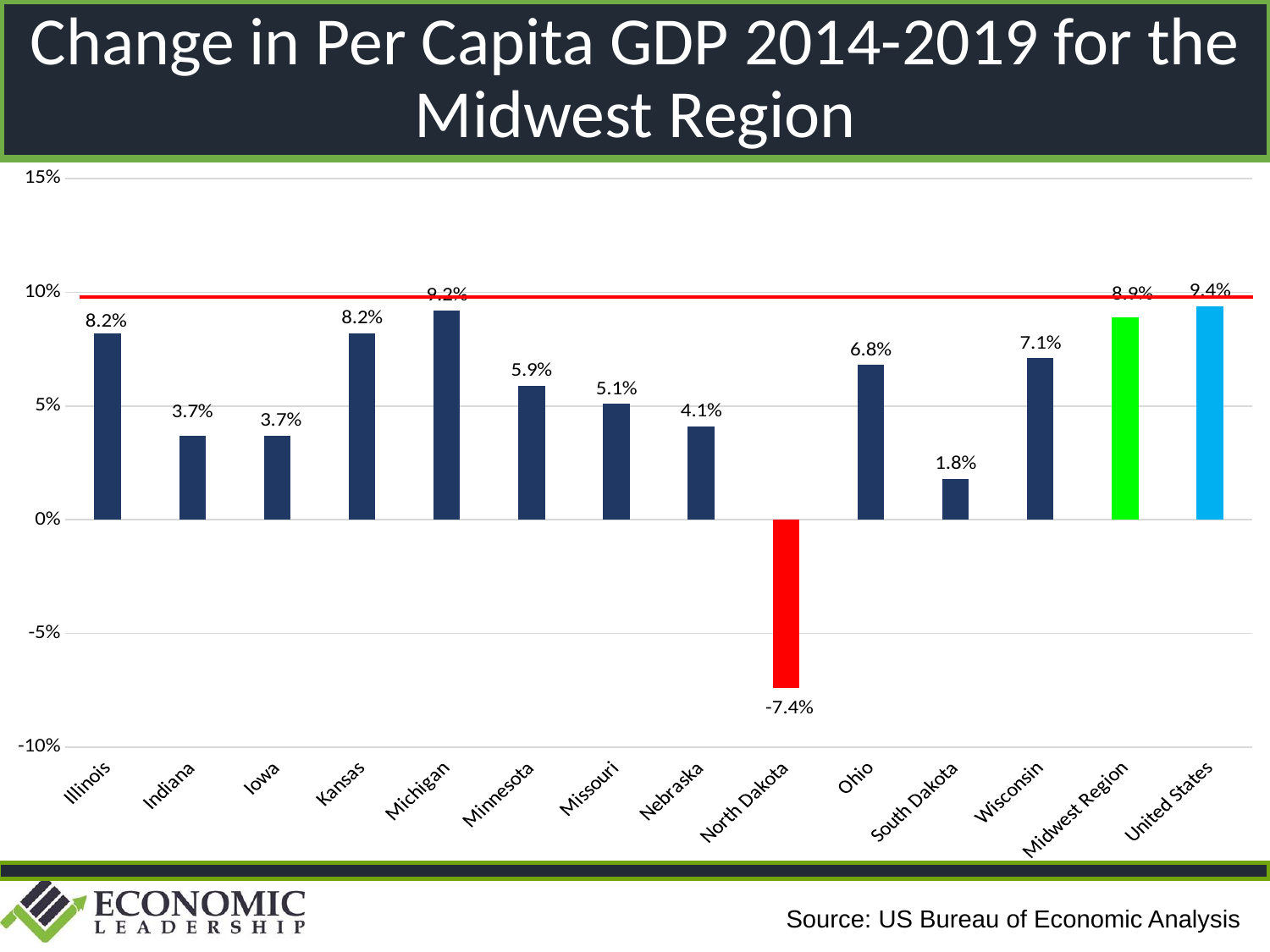
What kind of chart is shown on the slide? bar chart What is the change in per capita GDP for North Dakota? -7.4% What colour is the bar for North Dakota? red What is the difference between the values for Ohio and Nebraska? 2.7 percentage points How many categories are shown on the x axis? 14 What is the difference between the values for Kansas and Indiana? 4.5 percentage points What is the change in per capita GDP for South Dakota? 1.8% Which has a larger change in per capita GDP, Wisconsin or Minnesota? Wisconsin Is the value for Midwest Region greater or less than 5%? greater What is the change in per capita GDP for Illinois? 8.2% What is the change in per capita GDP for Missouri? 5.1% Which category has the lowest change in per capita GDP? North Dakota